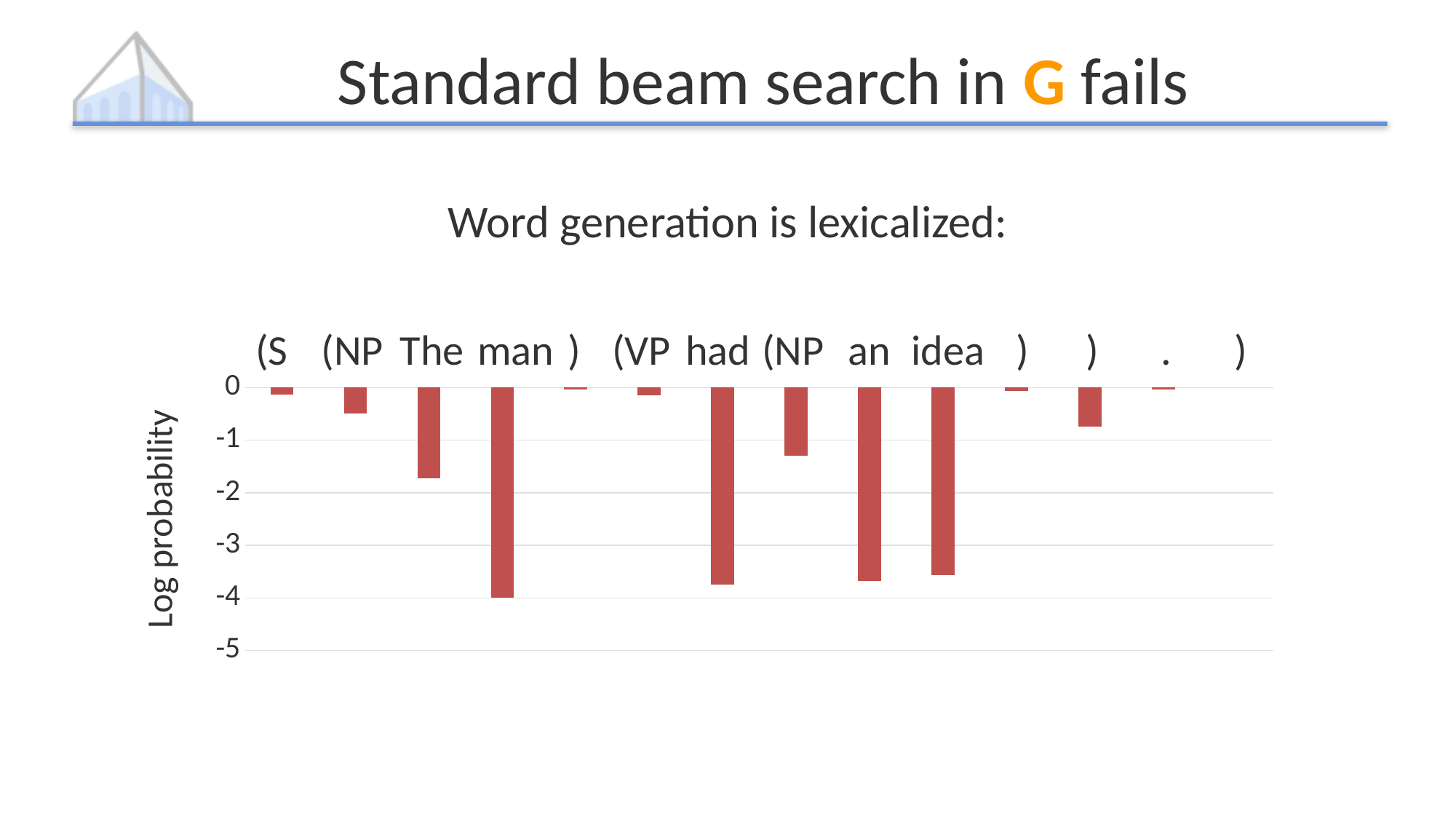
Is the value for 'The' greater or less than -1? less Which has the lower log probability, 'The' or 'had'? had Which category has the lowest log probability? man What kind of chart is shown on the slide? bar chart Is the value for the second '(NP' (the one before 'an') greater or less than -1? less How many bars (categories) does the chart have? 14 Is the value for 'an' greater or less than -3? less What is the label of the vertical axis? Log probability Which has the higher log probability, 'The' or 'man'? The What is the title of the slide containing the chart? Standard beam search in G fails